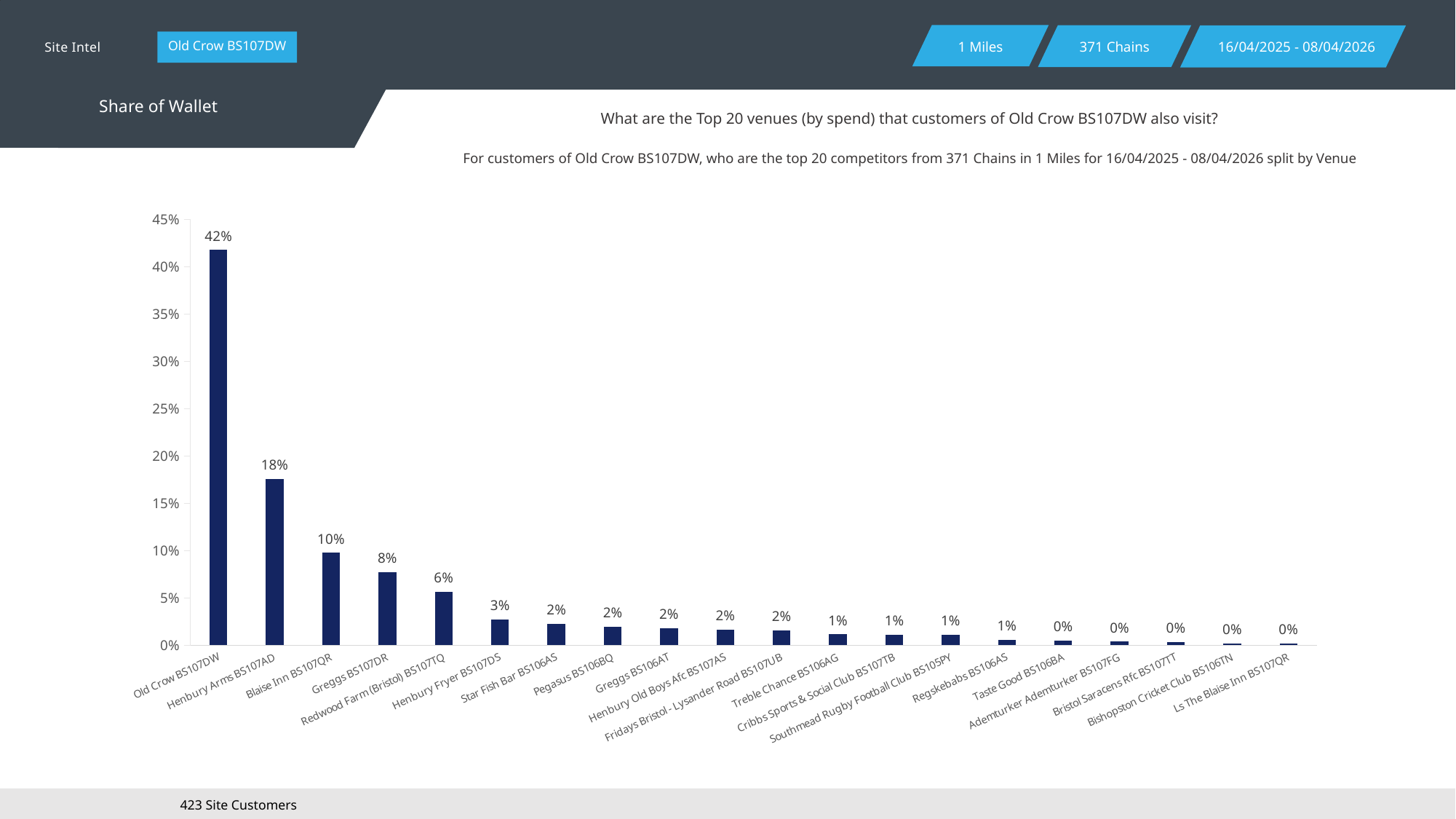
What is the value for Henbury Arms BS107AD? 18% What is the value for Henbury Fryer BS107DS? 3% What is the value for Redwood Farm (Bristol) BS107TQ? 6% How many venues are shown on the chart? 20 What is the value for Old Crow BS107DW? 42% What is the value for Treble Chance BS106AG? 1% Which is larger, the value for Blaise Inn BS107QR or the value for Greggs BS107DR? Blaise Inn BS107QR Which venue has the highest value? Old Crow BS107DW Do the values rise or fall from left to right along the x axis? fall Is the value for Henbury Arms BS107AD greater or less than 20%? less What is the difference between the values for Old Crow BS107DW and Henbury Arms BS107AD? 24 percentage points What kind of chart is shown on the slide? bar chart